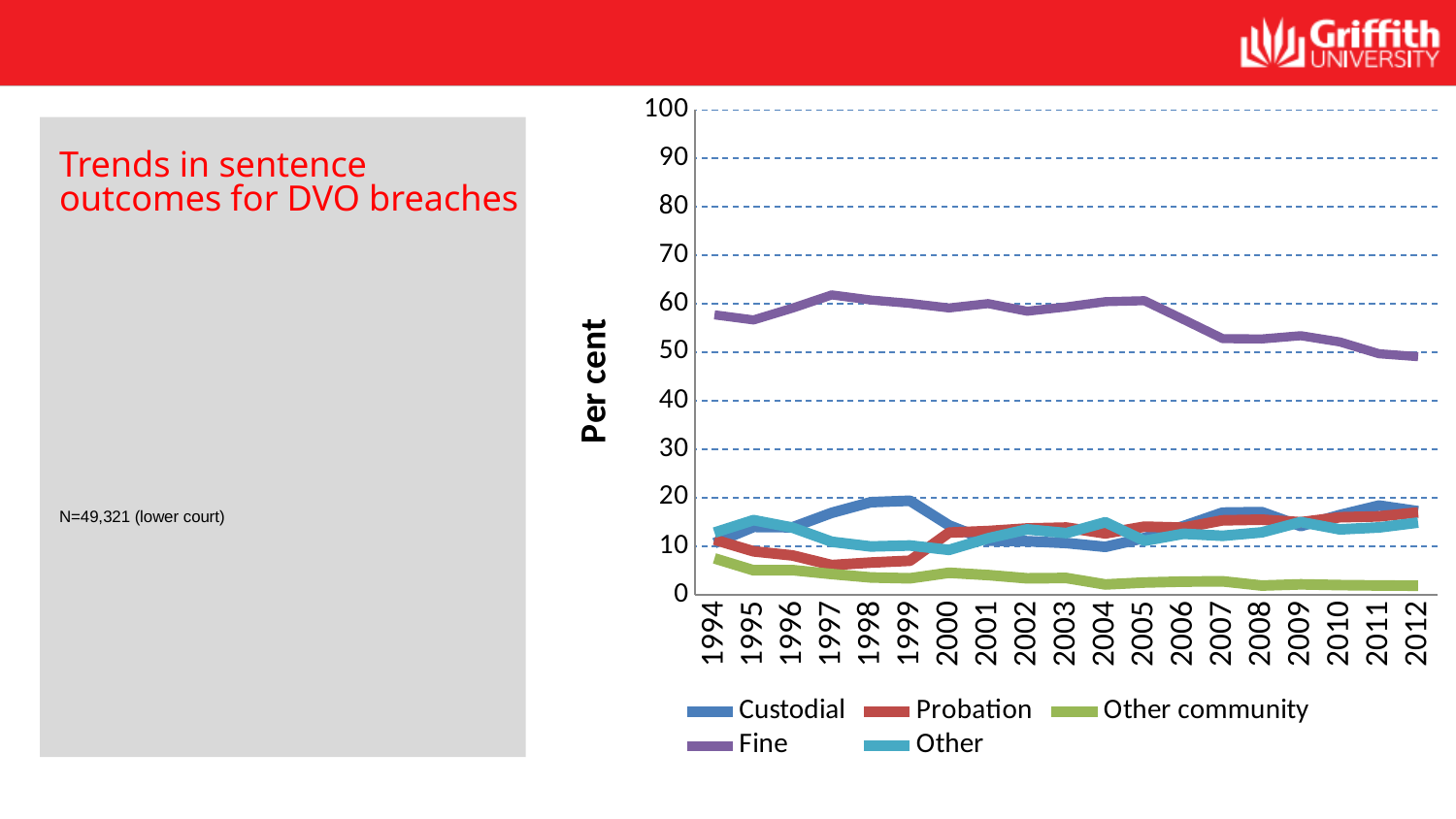
Is the value for Other community in 2012 greater or less than 10? less Does the Fine series rise or fall from 2005 to 2012? fall Which is larger in 2000, Fine or Custodial? Fine How many series does the legend list? 5 Is the value for Fine in 2007 greater or less than 60? less Which series has the lowest value in 2012? Other community Is the value for Fine in 1997 greater or less than 50? greater How many years are plotted along the x axis? 19 What is the label on the y axis? Per cent Which series has the highest values across all years? Fine What kind of chart is shown on the slide? line chart